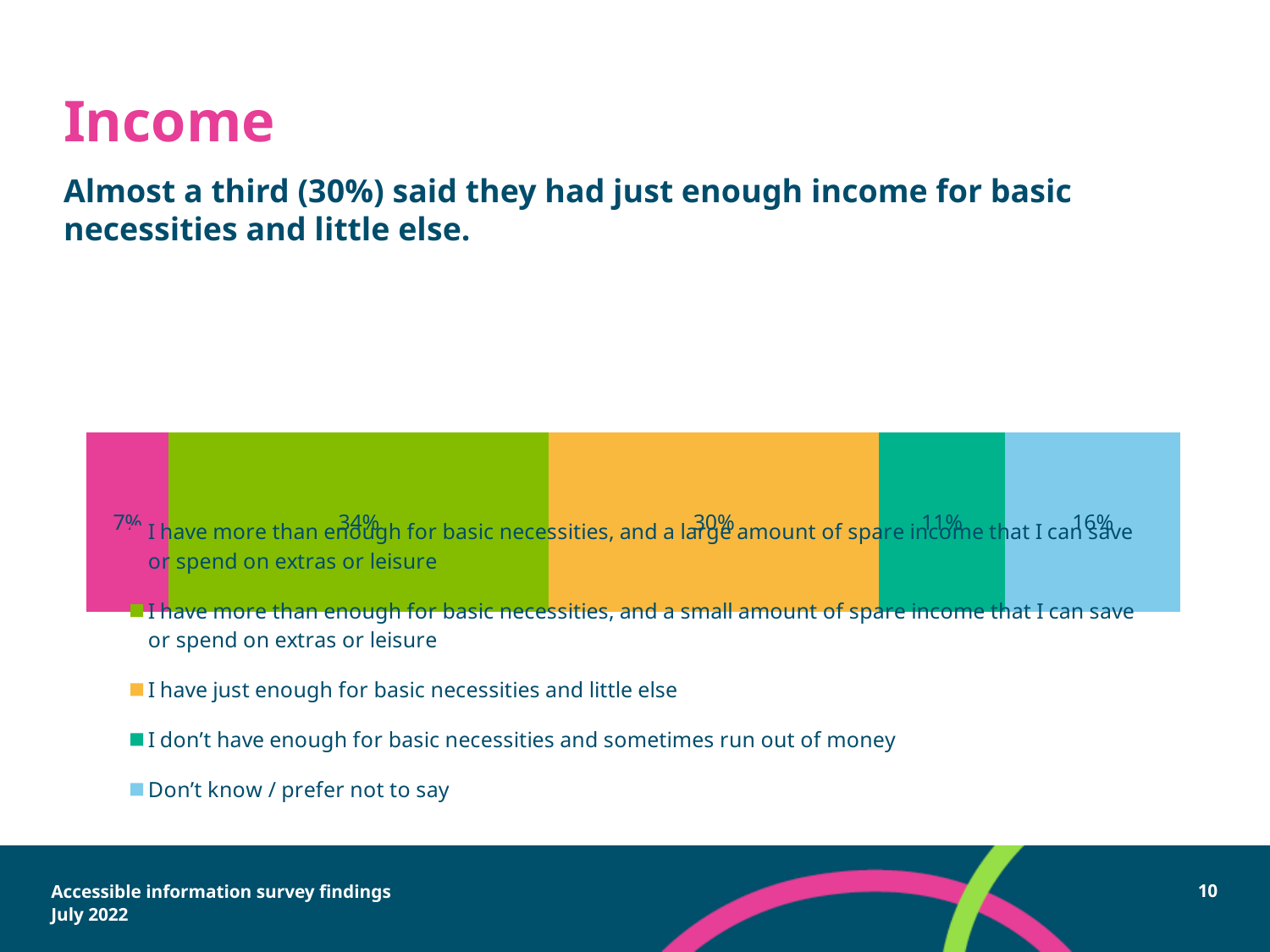
Which response category has the largest share in the bar? I have more than enough for basic necessities, and a small amount of spare income that I can save or spend on extras or leisure What percentage of respondents said they don't have enough for basic necessities and sometimes run out of money? 11% How many response categories are shown in the bar? 5 What percentage of respondents answered 'Don't know / prefer not to say'? 16% What percentage of respondents said they have more than enough for basic necessities and a small amount of spare income? 34% What colour is the segment representing 'I have just enough for basic necessities and little else'? Orange What percentage of respondents said they have more than enough for basic necessities and a large amount of spare income? 7% Which response category has the smallest share in the bar? I have more than enough for basic necessities, and a large amount of spare income that I can save or spend on extras or leisure Which is larger: the share who answered 'Don't know / prefer not to say' or the share who don't have enough for basic necessities? Don't know / prefer not to say What is the difference between the share who have just enough for basic necessities (30%) and the share who don't have enough (11%)? 19 percentage points What type of chart is shown on the slide? Stacked bar chart What percentage of respondents said they have just enough for basic necessities and little else? 30%